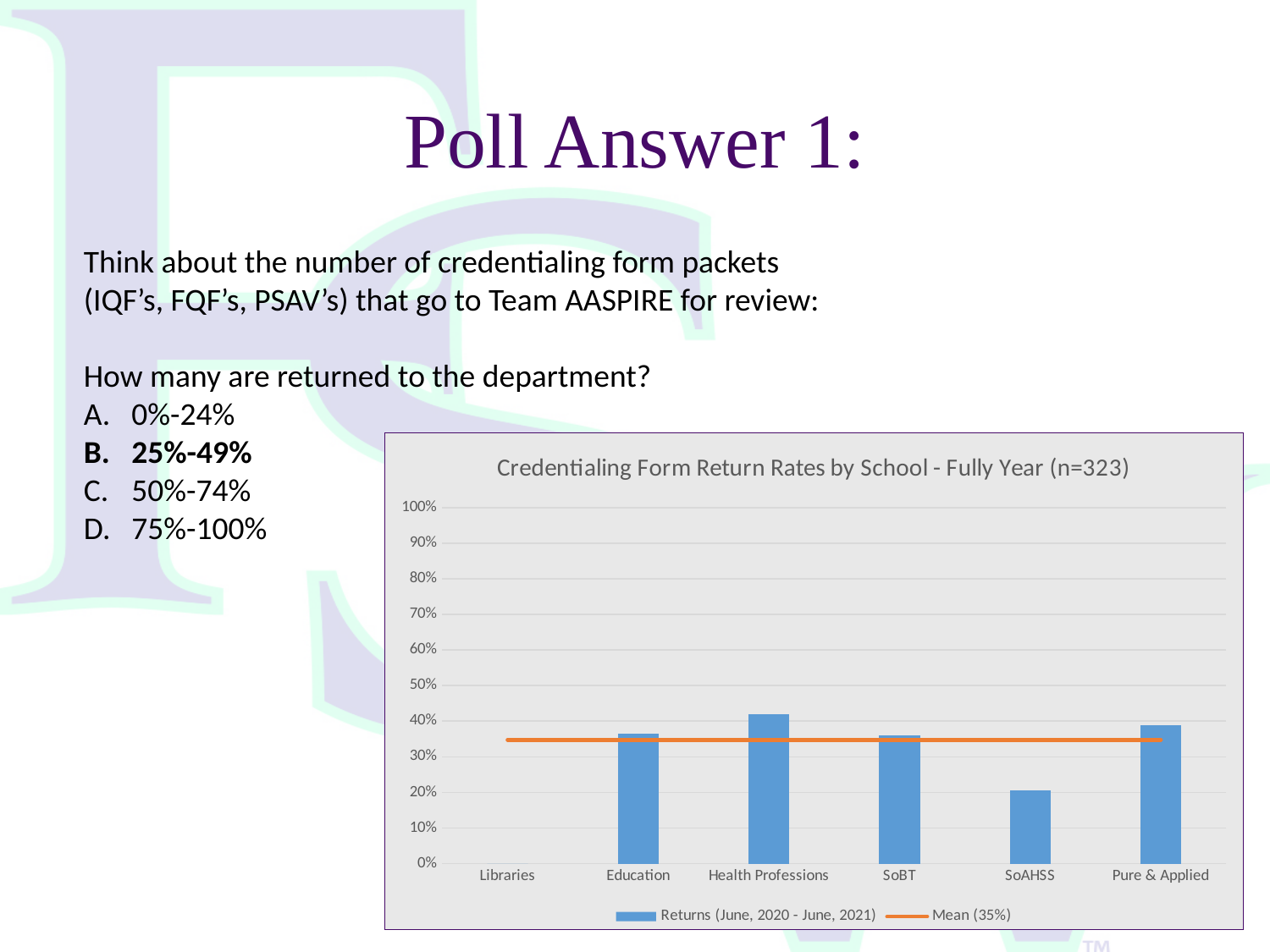
What mean value is given in the chart legend? 35% What is the title of the chart? Credentialing Form Return Rates by School - Fully Year (n=323) What kind of chart is shown on the slide? Combination bar and line chart Which school has the lowest return rate? Libraries Is the return rate for Pure & Applied greater or less than 30%? greater Which has a higher return rate, Health Professions or SoAHSS? Health Professions Which school has the highest return rate? Health Professions Is the return rate for Health Professions greater or less than 40%? greater How many schools are shown on the x axis of the chart? 6 Is the return rate for SoAHSS greater or less than 30%? less How many entries does the chart legend list? 2 Which has a higher return rate, Pure & Applied or SoAHSS? Pure & Applied